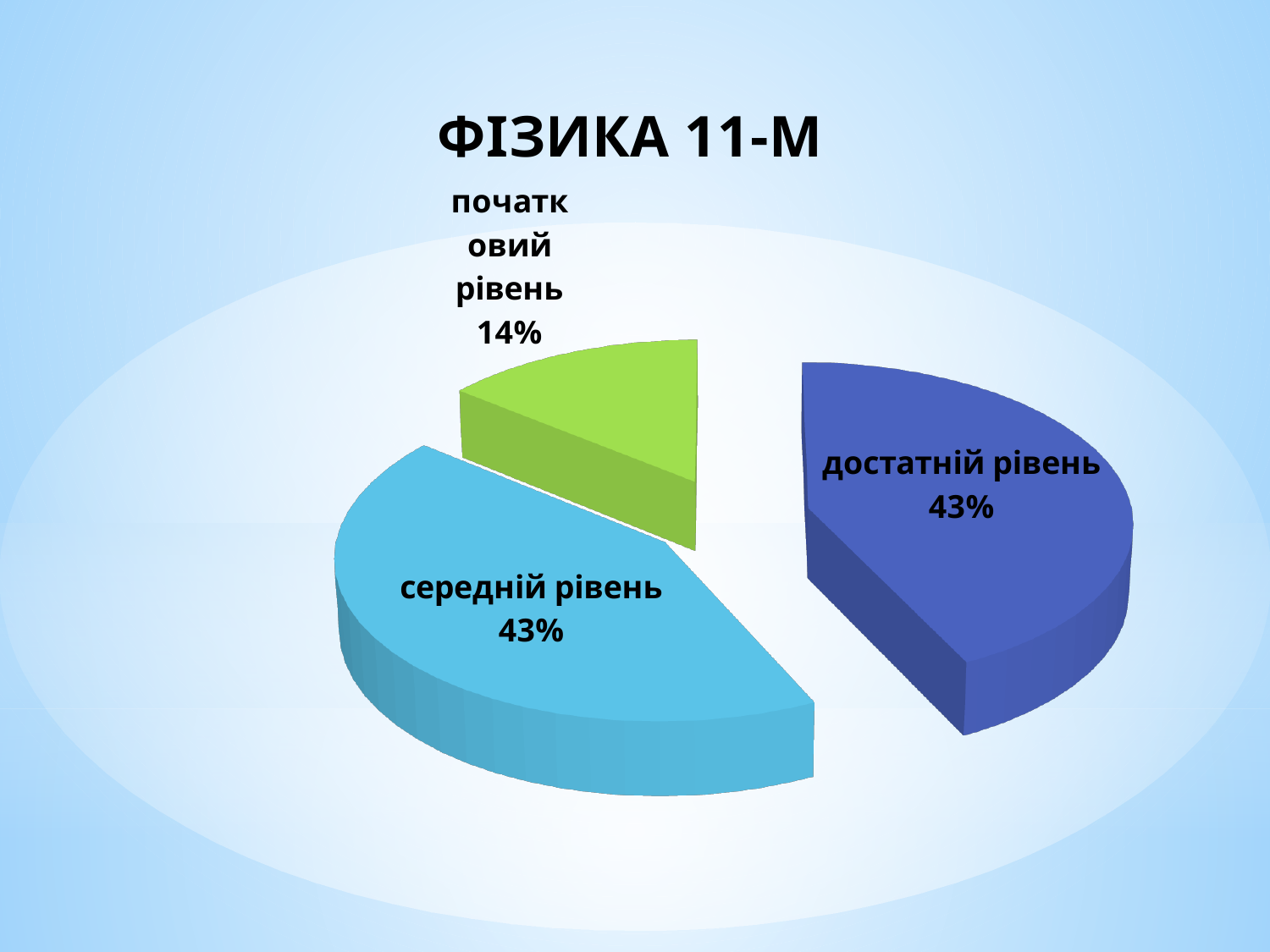
What colour is the slice for "початковий рівень"? green Which is larger, the slice for "середній рівень" or the slice for "початковий рівень"? середній рівень Is the share for "середній рівень" greater or less than 40%? greater What share of the pie is labelled "середній рівень"? 43% What is the title of the chart? ФІЗИКА 11-М What share of the pie is labelled "достатній рівень"? 43% How many slices does the pie chart have? 3 What type of chart is shown on the slide? pie chart Which slice of the pie is the smallest? початковий рівень What share of the pie is labelled "початковий рівень"? 14% What is the difference in percentage points between "достатній рівень" and "початковий рівень"? 29%